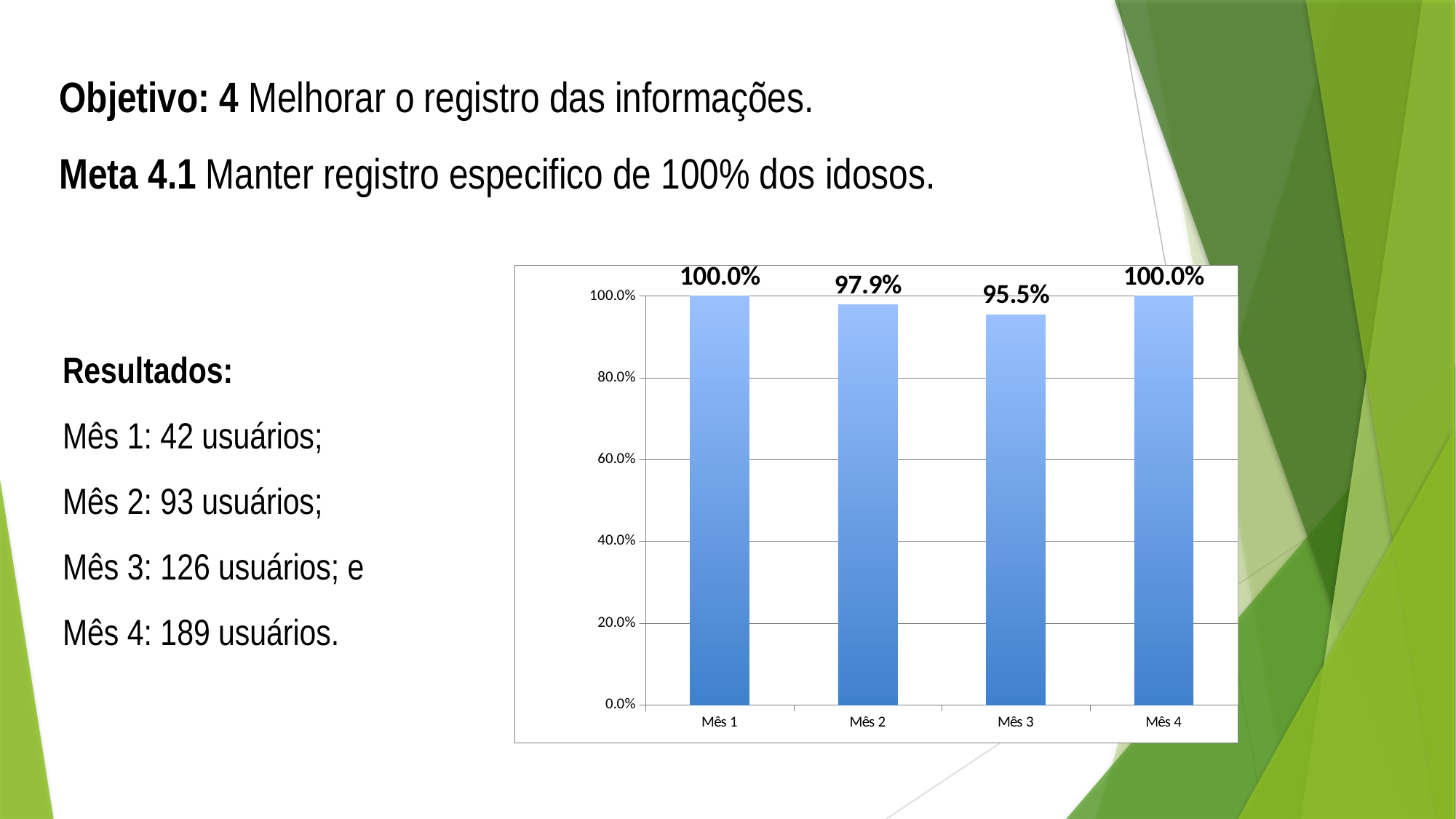
What is the value shown for Mês 2? 97.9% What is the value shown for Mês 3? 95.5% What is the difference between the values for Mês 1 and Mês 3? 4.5% What kind of chart is shown on the slide? bar chart What is the value shown for Mês 1? 100.0% What is the value shown for Mês 4? 100.0% Which is larger, the value for Mês 2 or the value for Mês 3? Mês 2 What is the difference between the values for Mês 2 and Mês 3? 2.4% Which month has the lowest value in the chart? Mês 3 Which months share the highest value in the chart? Mês 1 and Mês 4 Is the value for Mês 3 greater or less than 80.0%? greater How many months (categories) are plotted in the chart? 4